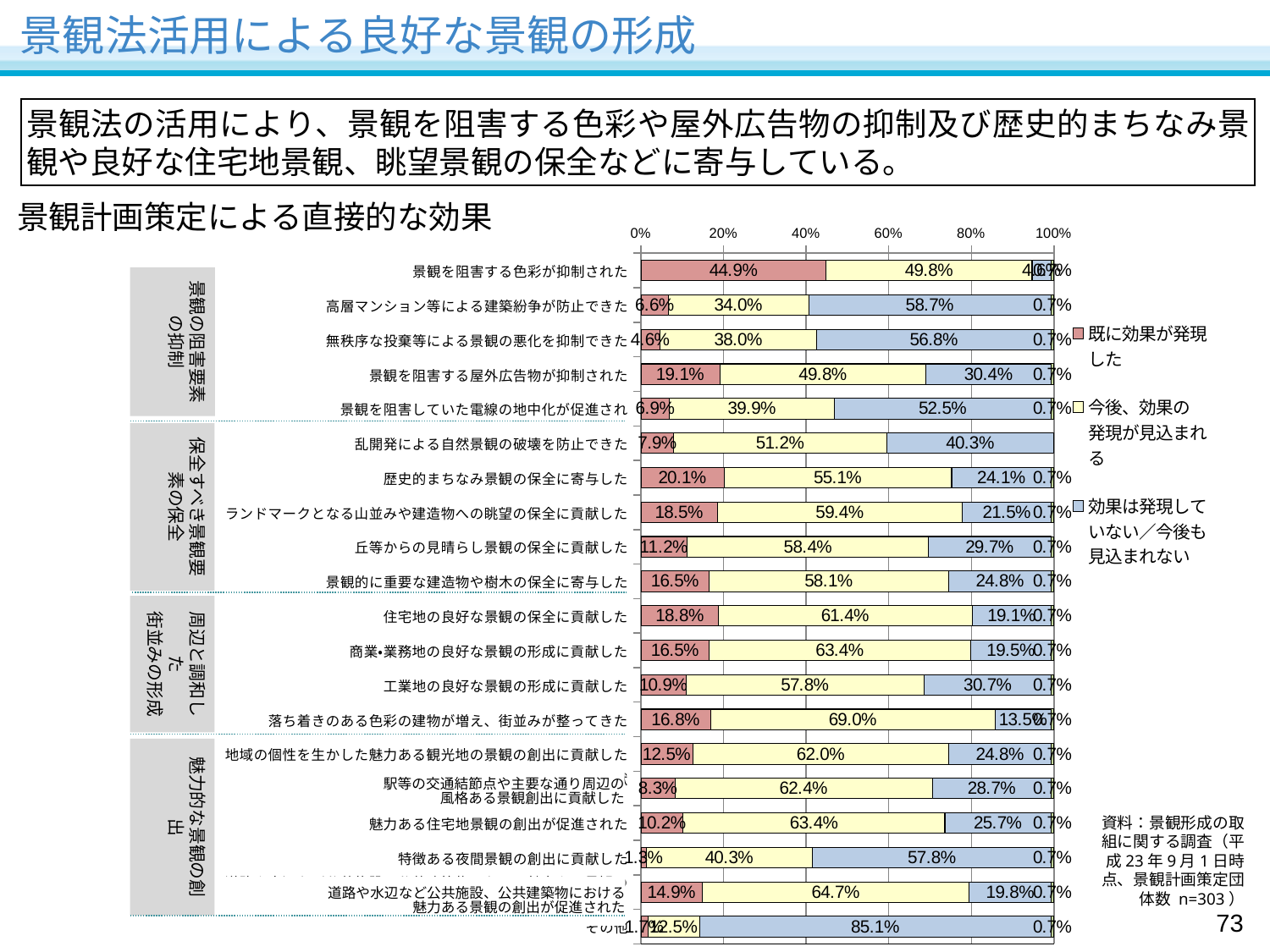
Which is larger: the 既に効果が発現した value for 景観を阻害する屋外広告物が抑制された or for 丘等からの見晴らし景観の保全に貢献した? 景観を阻害する屋外広告物が抑制された What is the value of 既に効果が発現した for 景観を阻害する色彩が抑制された? 44.9% Which category has the highest value for 既に効果が発現した? 景観を阻害する色彩が抑制された What kind of chart is shown on the slide? Stacked bar chart What colour represents 既に効果が発現した in the chart? Red Is the 効果は発現していない／今後も見込まれない value for 景観を阻害していた電線の地中化が促進された greater or less than 40%? greater What is the value of 既に効果が発現した for 歴史的まちなみ景観の保全に寄与した? 20.1% What is the value of 効果は発現していない／今後も見込まれない for 高層マンション等による建築紛争が防止できた? 58.7% What is the value of 効果は発現していない／今後も見込まれない for 工業地の良好な景観の形成に貢献した? 30.7% What is the value of 今後、効果の発現が見込まれる for 落ち着きのある色彩の建物が増え、街並みが整ってきた? 69.0% What is the difference between the 今後、効果の発現が見込まれる values for 道路や水辺など公共施設、公共建築物における魅力ある景観の創出が促進された (64.7%) and 特徴ある夜間景観の創出に貢献した (40.3%)? 24.4% How many series does the chart legend list? 3